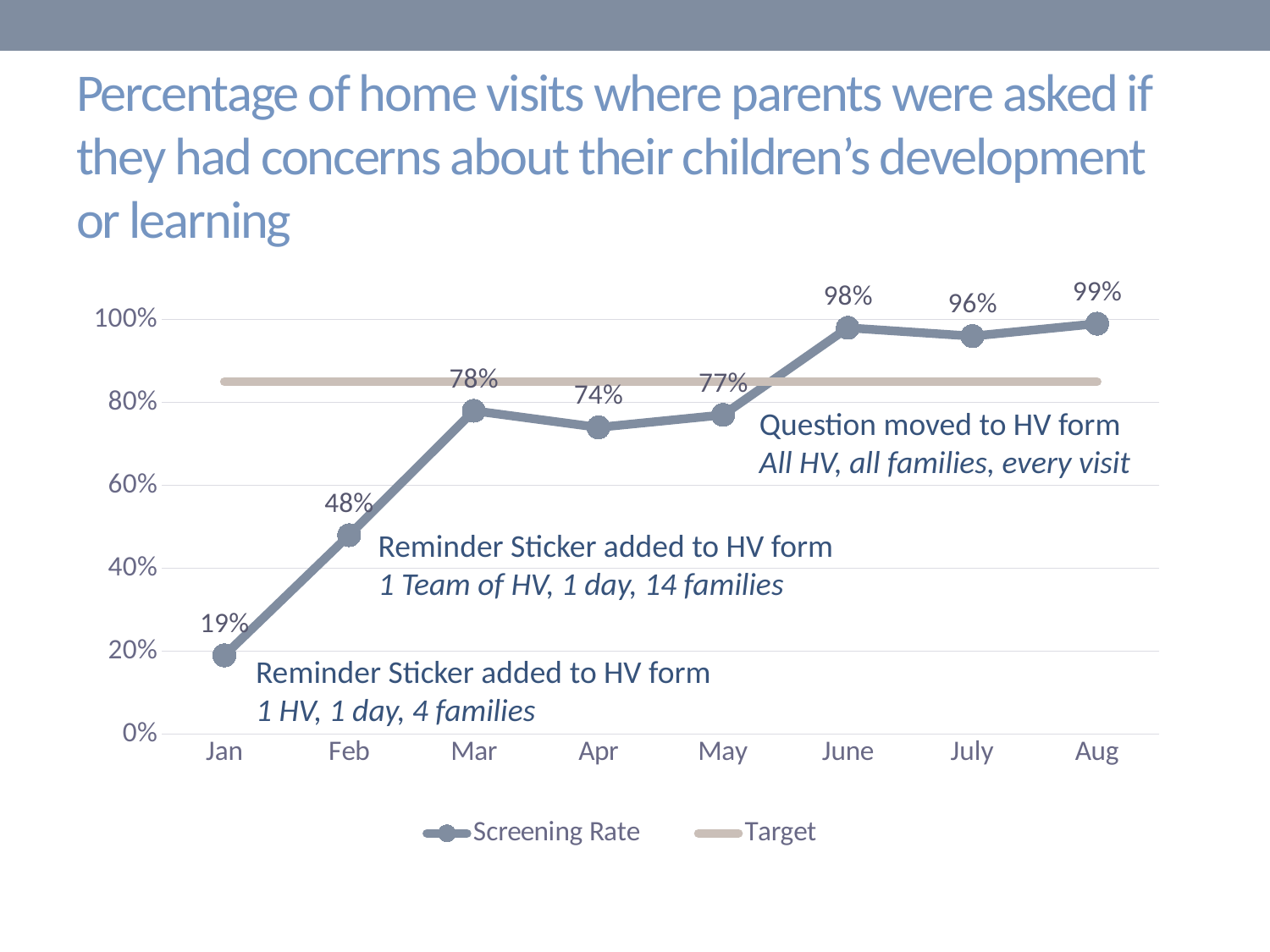
Does the Screening Rate generally rise or fall from January to August? rise Which month has the lowest Screening Rate? Jan What is the Screening Rate for January? 19% What is the Screening Rate for March? 78% Which month has the highest Screening Rate? Aug How many series does the legend list? 2 Is the Target line value greater or less than 80%? greater How many months are plotted on the x axis? 8 Which month has a higher Screening Rate, April or May? May What is the Screening Rate for July? 96% What is the difference between the Screening Rate in February and in January? 29% What kind of chart is shown on the slide? line chart